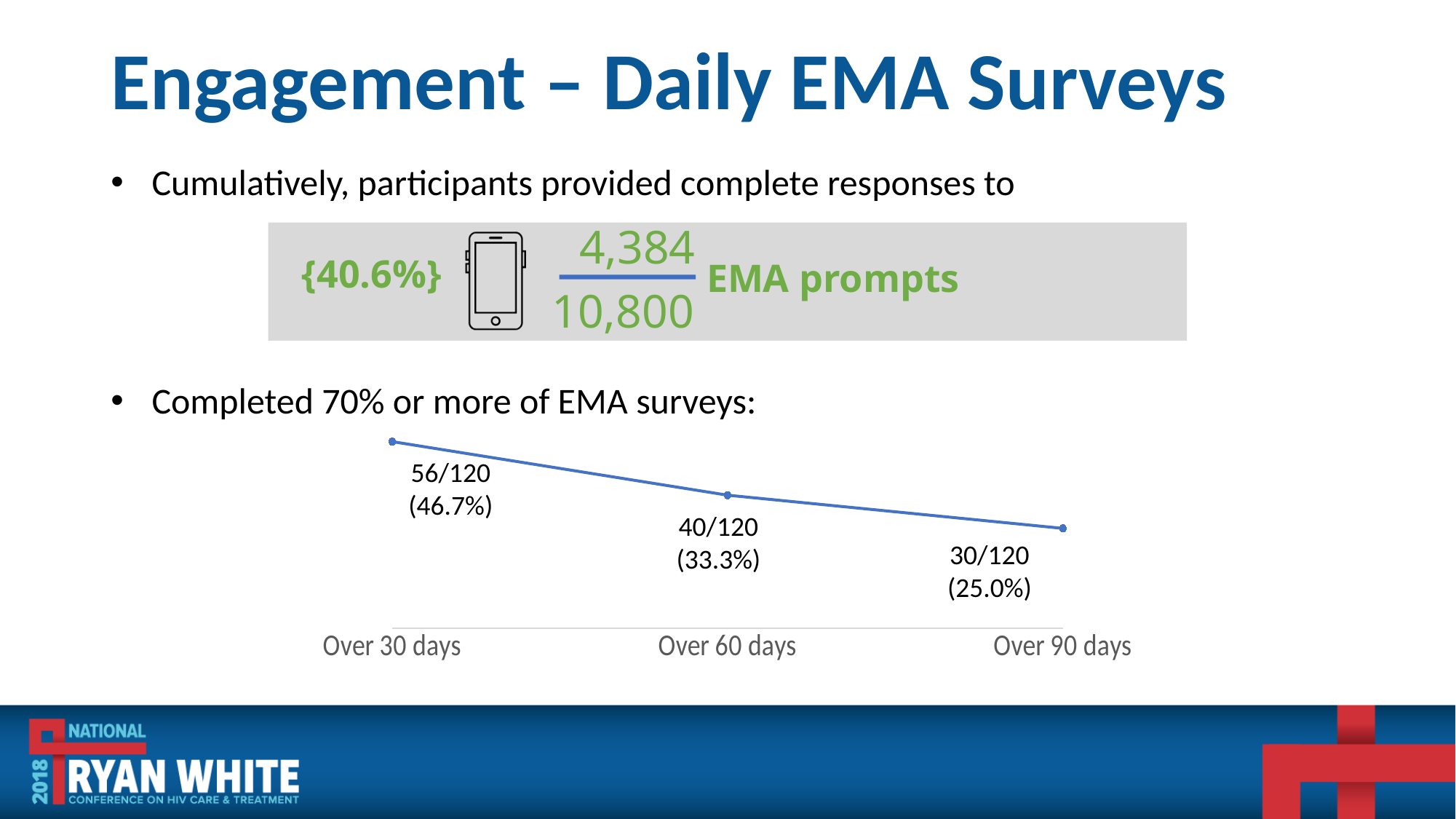
Which category on the line chart has the lowest value? Over 90 days What percentage of participants completed 70% or more of EMA surveys over 90 days? 25.0% Which is larger on the line chart: the value for 'Over 30 days' or 'Over 90 days'? Over 30 days How many more participants completed 70% or more of EMA surveys over 30 days than over 60 days? 16 How many data points are plotted on the line chart? 3 Do the values on the line chart rise or fall from 'Over 30 days' to 'Over 90 days'? fall What is the data label for 'Over 30 days' on the line chart? 56/120 (46.7%) Which category on the line chart has the highest value? Over 30 days What is the data label for 'Over 90 days' on the line chart? 30/120 (25.0%) What is the data label for 'Over 60 days' on the line chart? 40/120 (33.3%) What is the difference in percentage points between 'Over 60 days' and 'Over 90 days' on the line chart? 8.3 What kind of chart is shown on the slide? line chart